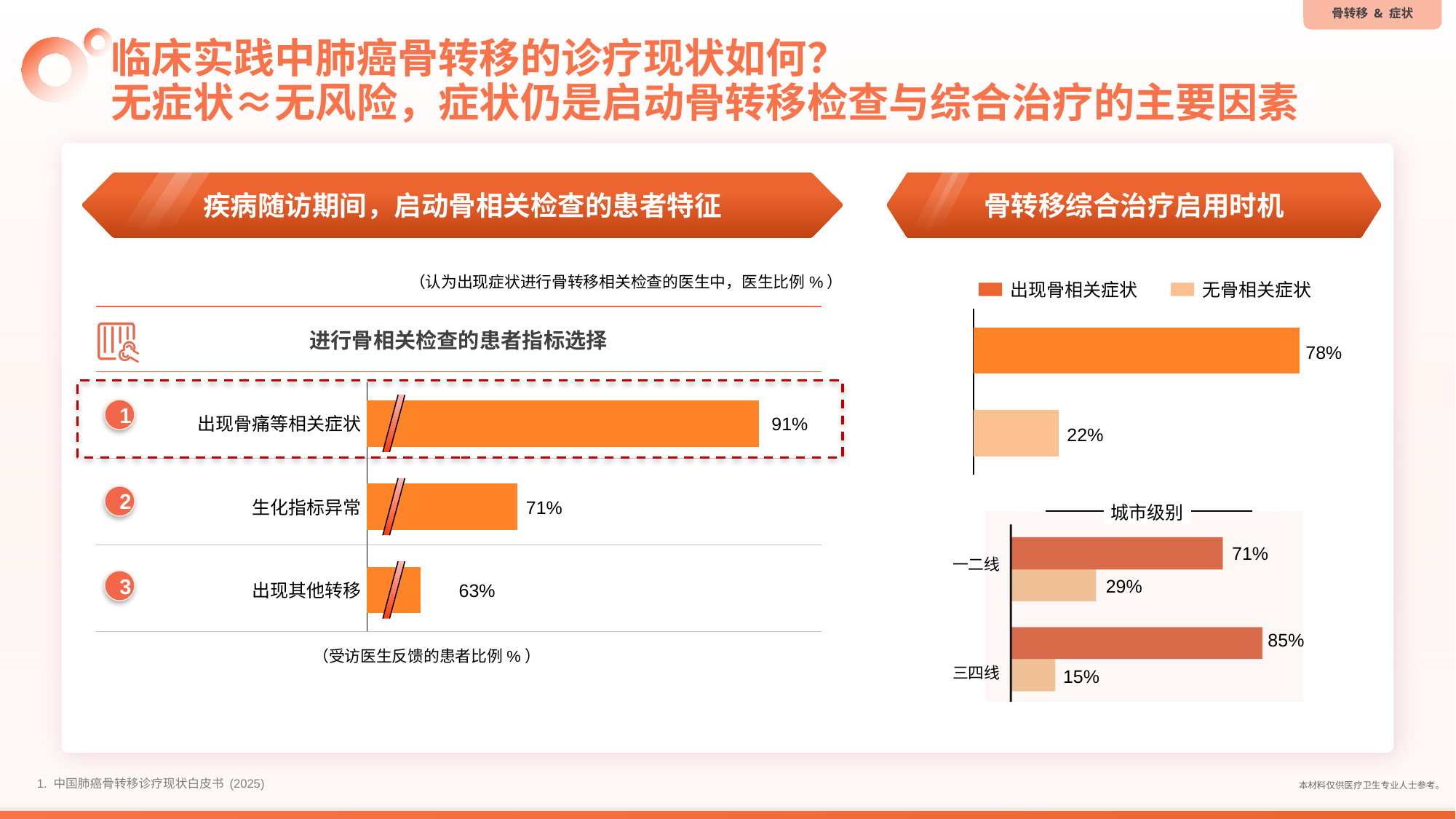
在“骨转移综合治疗启用时机”图中，“出现骨相关症状”与“无骨相关症状”的数值相差多少？ 56% 在“疾病随访期间，启动骨相关检查的患者特征”图中，“出现骨痛等相关症状”的数值是多少？ 91% 在“骨转移综合治疗启用时机”图中，“出现骨相关症状”的数值是多少？ 78% “疾病随访期间，启动骨相关检查的患者特征”图中共有几个指标类别？ 3 在“疾病随访期间，启动骨相关检查的患者特征”图中，“生化指标异常”的数值是多少？ 71% 在“疾病随访期间，启动骨相关检查的患者特征”图中，哪个指标的比例最低？ 出现其他转移 在“骨转移综合治疗启用时机”图的“城市级别”部分，“出现骨相关症状”的数值是“一二线”高还是“三四线”高？ 三四线 在“疾病随访期间，启动骨相关检查的患者特征”图中，“出现骨痛等相关症状”与“出现其他转移”的数值相差多少？ 28% “疾病随访期间，启动骨相关检查的患者特征”图是什么类型的图表？ 条形图 在“骨转移综合治疗启用时机”图的“城市级别”部分，“一二线”的“无骨相关症状”数值是多少？ 29% “骨转移综合治疗启用时机”图的图例列出了几个系列？ 2 在“骨转移综合治疗启用时机”图的“城市级别”部分，“三四线”的“出现骨相关症状”数值是多少？ 85%